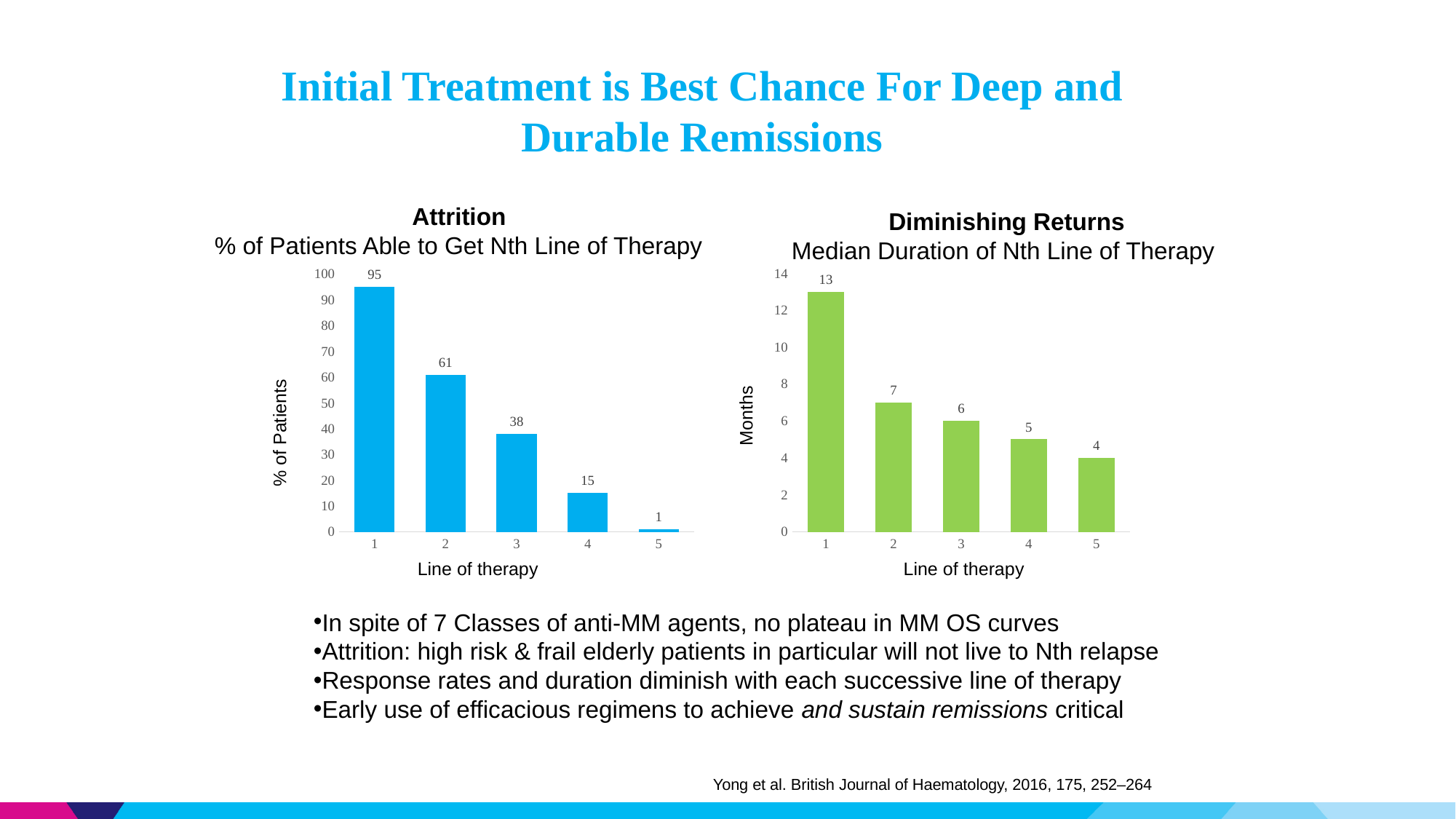
In the Diminishing Returns chart, which line of therapy has the highest median duration? 1 In the Diminishing Returns chart, do the values rise or fall as the line of therapy increases? Fall In the Attrition chart, what is the difference between the values for line of therapy 1 and line of therapy 2? 34 In the Diminishing Returns chart, what is the median duration in months for line of therapy 2? 7 What is the y-axis label of the Diminishing Returns chart? Months In the Attrition chart, is the value for line of therapy 3 greater or less than 40? less In the Attrition chart, which is larger: the value for line of therapy 2 or line of therapy 4? Line of therapy 2 What kind of chart is the Attrition chart? Bar chart How many lines of therapy are shown in the Diminishing Returns chart? 5 In the Attrition chart, which line of therapy has the lowest value? 5 In the Attrition chart, what percentage of patients are able to get line of therapy 3? 38 In the Diminishing Returns chart, what is the difference in months between line of therapy 1 and line of therapy 5? 9